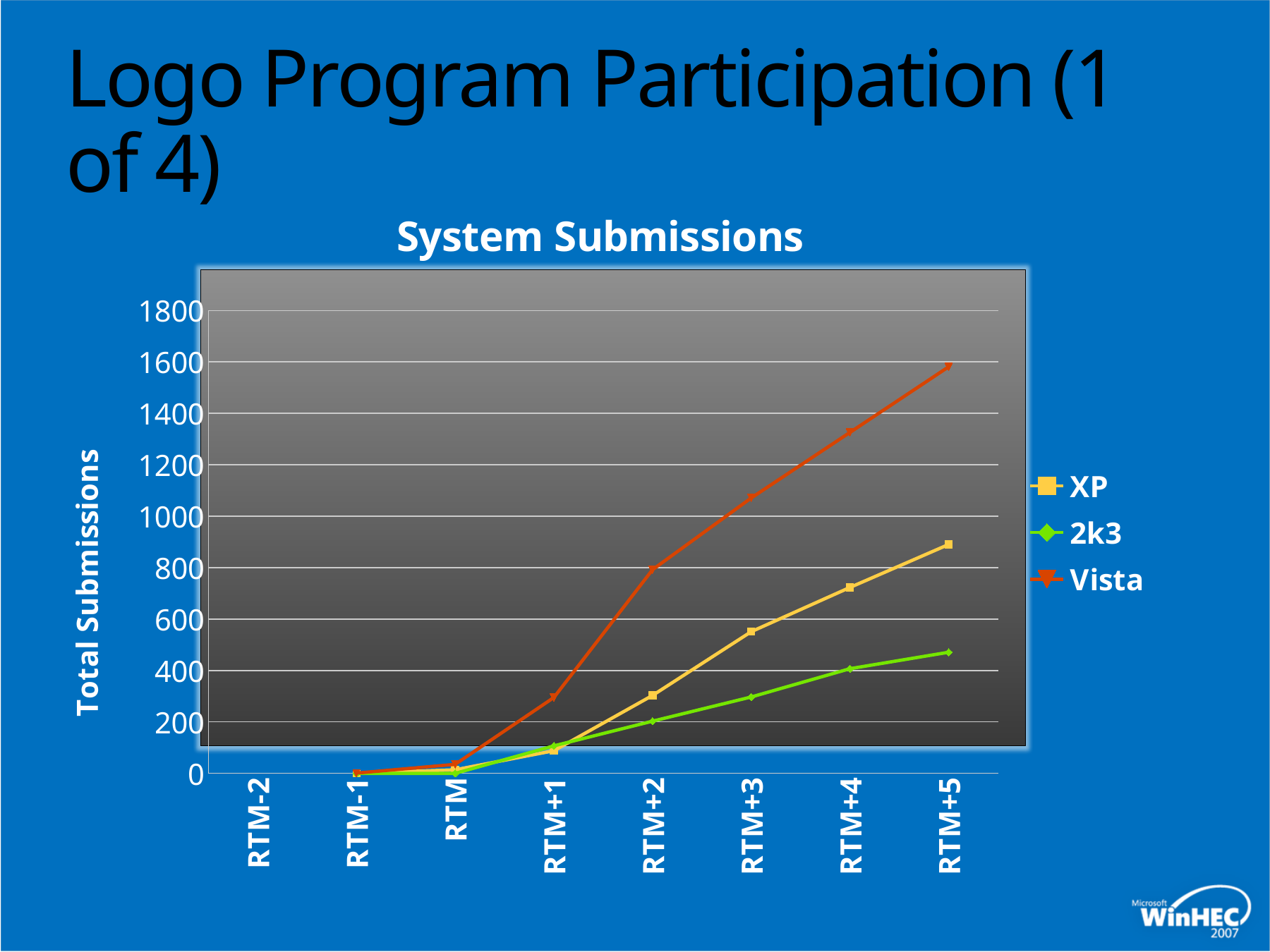
Is the value for Vista at RTM+3 greater or less than 1000? greater What kind of chart is shown on the slide? line chart Is the value for XP at RTM+4 greater or less than 600? greater How many categories are shown on the x axis? 8 Do the values for Vista rise or fall from RTM-1 to RTM+5? rise Is the value for 2k3 at RTM+5 greater or less than 600? less Which series has the lowest value at RTM+5? 2k3 What is the label of the y axis? Total Submissions At RTM+3, which series has the larger value, XP or 2k3? XP Which series has the highest value at RTM+5? Vista What is the title of the chart? System Submissions How many series does the legend list? 3